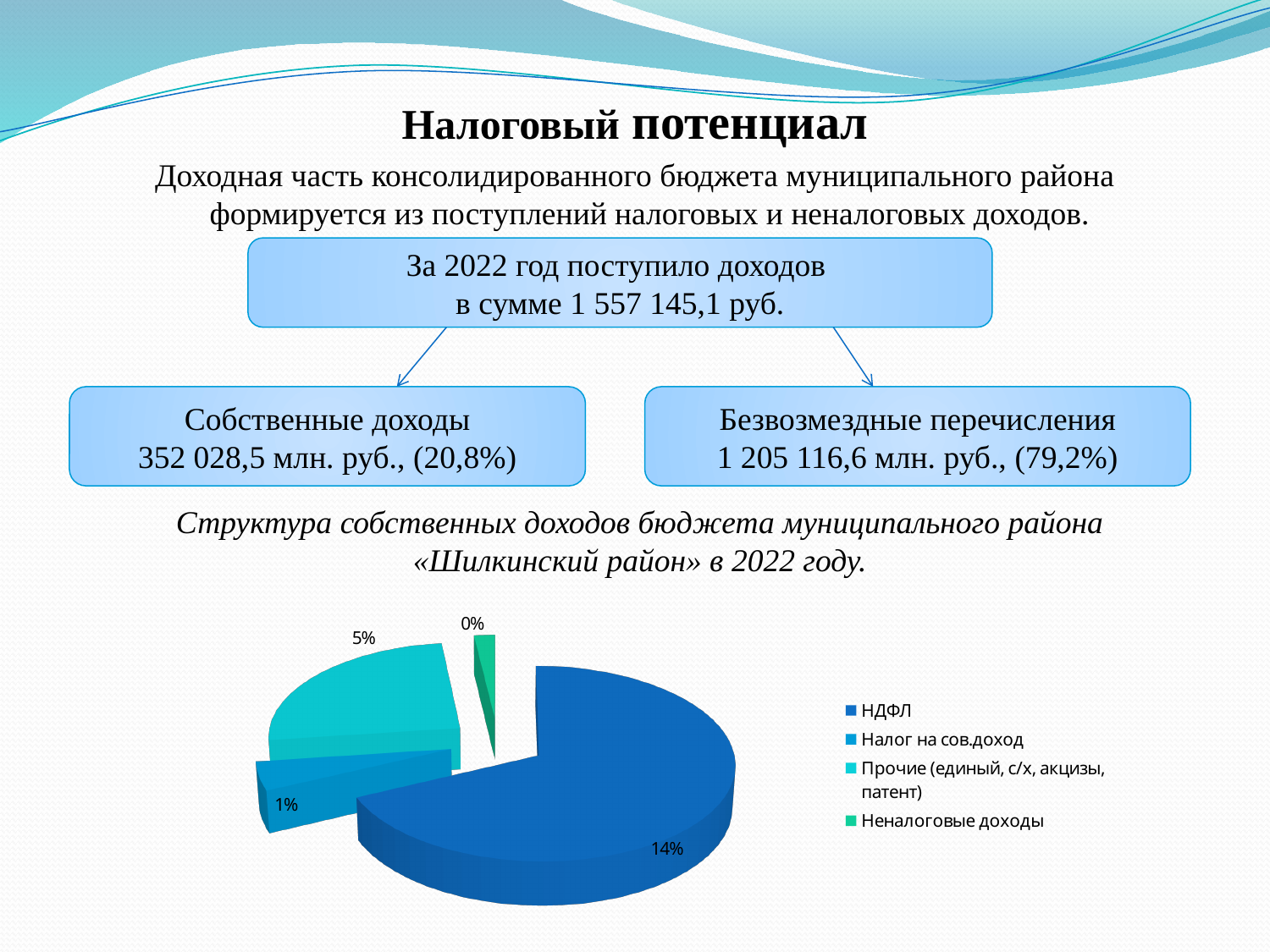
How many slices does the pie chart have? 4 What value is shown for Неналоговые доходы in the pie chart? 0% What is the difference between the values for НДФЛ and Прочие (единый, с/х, акцизы, патент) in the pie chart? 9% Which is larger in the pie chart: НДФЛ or Прочие (единый, с/х, акцизы, патент)? НДФЛ What value is shown for НДФЛ in the pie chart? 14% How many entries does the legend of the pie chart list? 4 What is the title above the pie chart? Структура собственных доходов бюджета муниципального района «Шилкинский район» в 2022 году. Which category has the smallest slice in the pie chart? Неналоговые доходы What value is shown for Прочие (единый, с/х, акцизы, патент) in the pie chart? 5% Which category has the largest slice in the pie chart? НДФЛ What value is shown for Налог на сов.доход in the pie chart? 1% What kind of chart is shown on the slide? pie chart